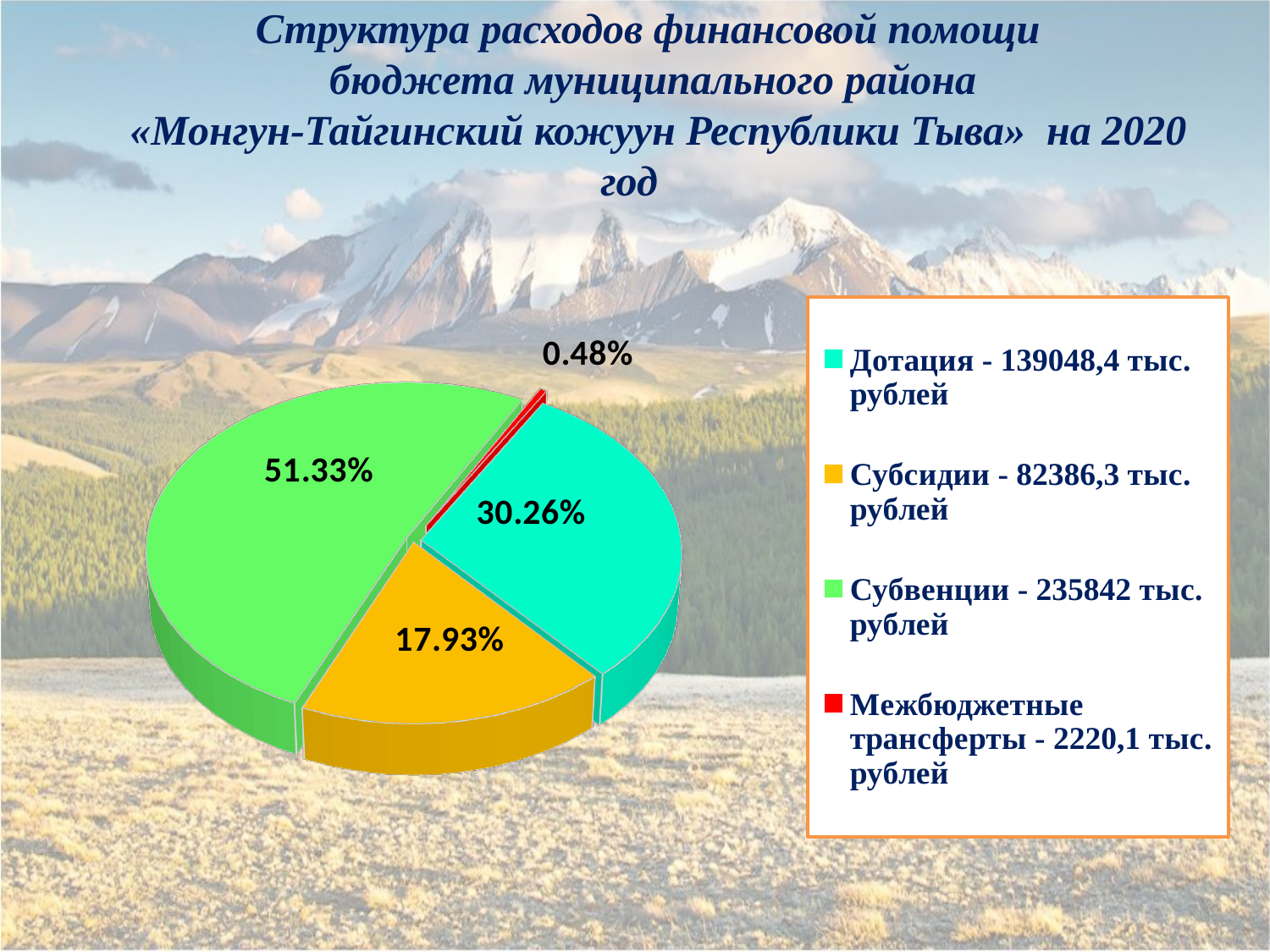
Which is larger, the share for Дотация or the share for Субсидии? Дотация Which category has the largest share of the pie? Субвенции How many slices does the pie chart have? 4 What kind of chart is shown on the slide? Pie chart What share of the pie does Субвенции take? 51.33% What is the difference in percentage points between the Субвенции share and the Дотация share? 21.07 According to the legend, what amount in тыс. рублей is given for Субсидии? 82386,3 тыс. рублей Which category has the smallest share of the pie? Межбюджетные трансферты What share of the pie does Субсидии take? 17.93% How many entries does the legend list? 4 What share of the pie does Дотация take? 30.26%